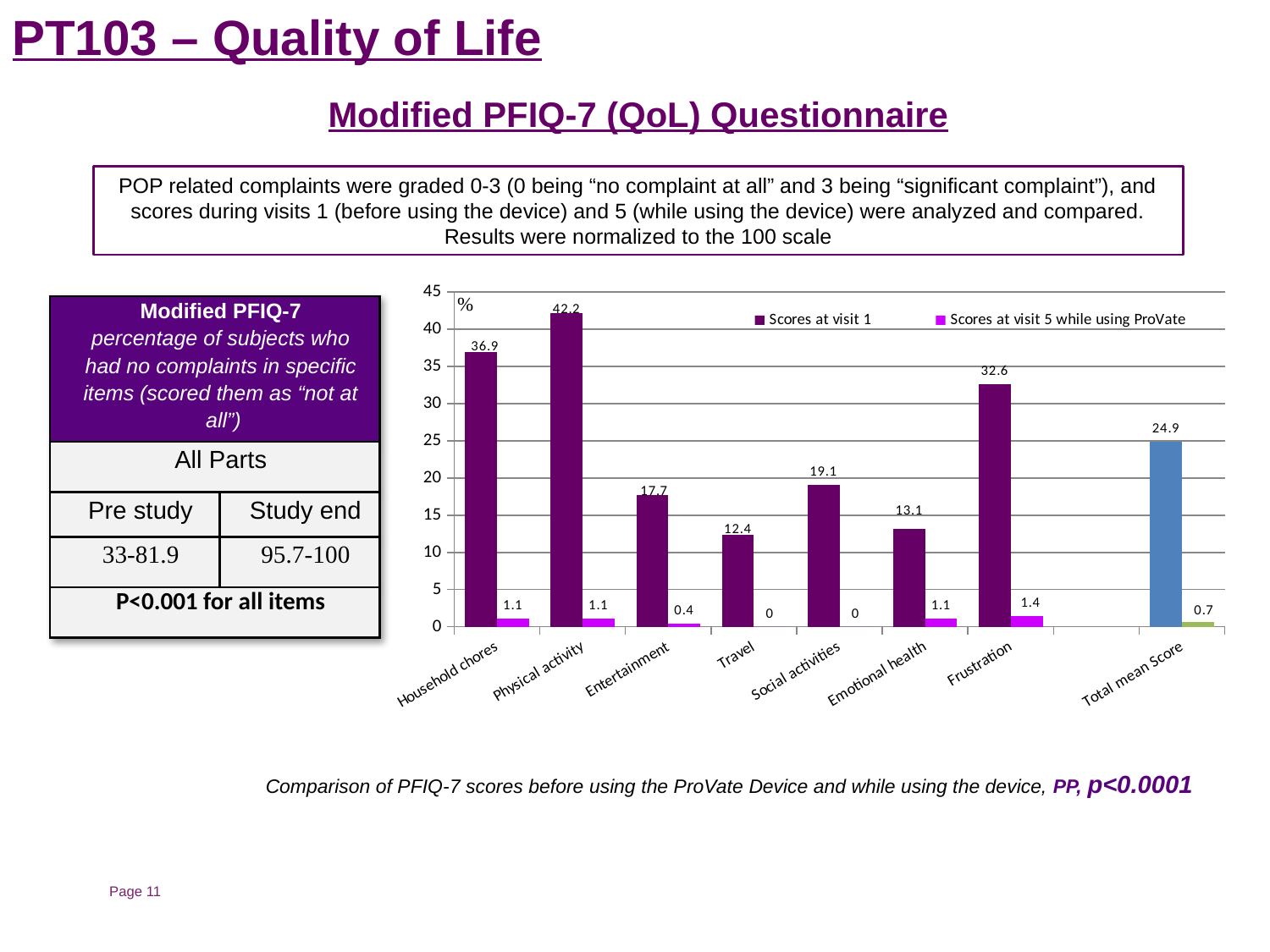
What is the score at visit 1 for Physical activity? 42.2 How many series does the chart legend list? 2 What is the score at visit 5 while using ProVate for Travel? 0 What kind of chart is shown on the slide? bar chart Which category has the lowest score at visit 1? Travel How many categories are shown on the x axis of the chart? 8 What is the score at visit 5 while using ProVate for Frustration? 1.4 Is the visit 1 score for Entertainment greater or less than 20? less Which is larger, the visit 1 score for Frustration or the visit 1 score for Social activities? Frustration Which category has the highest score at visit 1? Physical activity What is the score at visit 1 for Total mean Score? 24.9 What is the difference between the visit 1 score and the visit 5 score for Household chores? 35.8